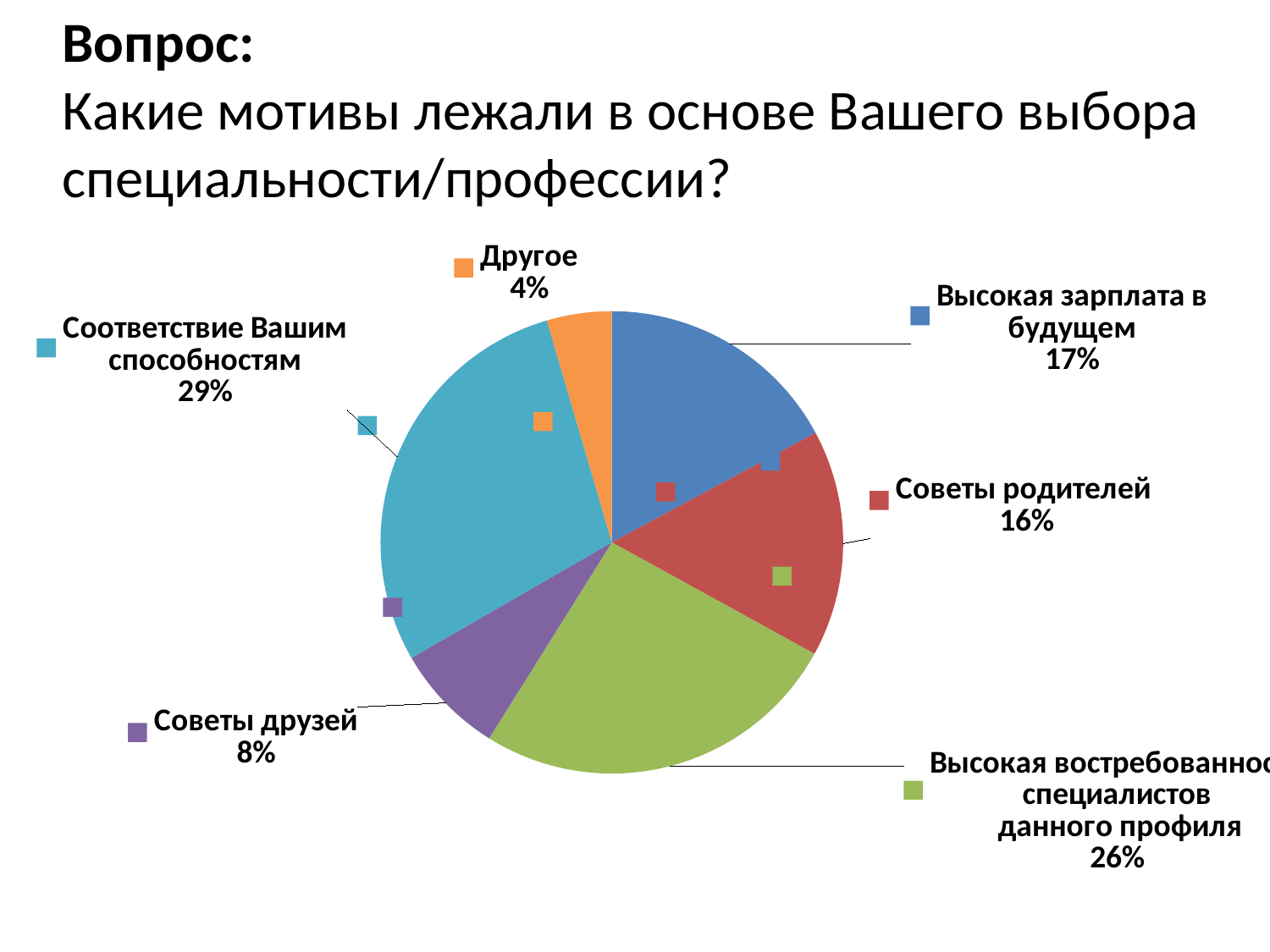
What share of the pie is "Советы друзей"? 8% Which category has the smallest slice of the pie? Другое Which is larger: "Высокая зарплата в будущем" or "Советы друзей"? Высокая зарплата в будущем How many slices does the pie chart have? 6 What is the difference in percentage points between "Соответствие Вашим способностям" and "Советы друзей"? 21 What share of the pie is "Советы родителей"? 16% Which category has the largest slice of the pie? Соответствие Вашим способностям What share of the pie is "Другое"? 4% What kind of chart is shown on the slide? Pie chart What colour is the slice for "Советы родителей"? Red